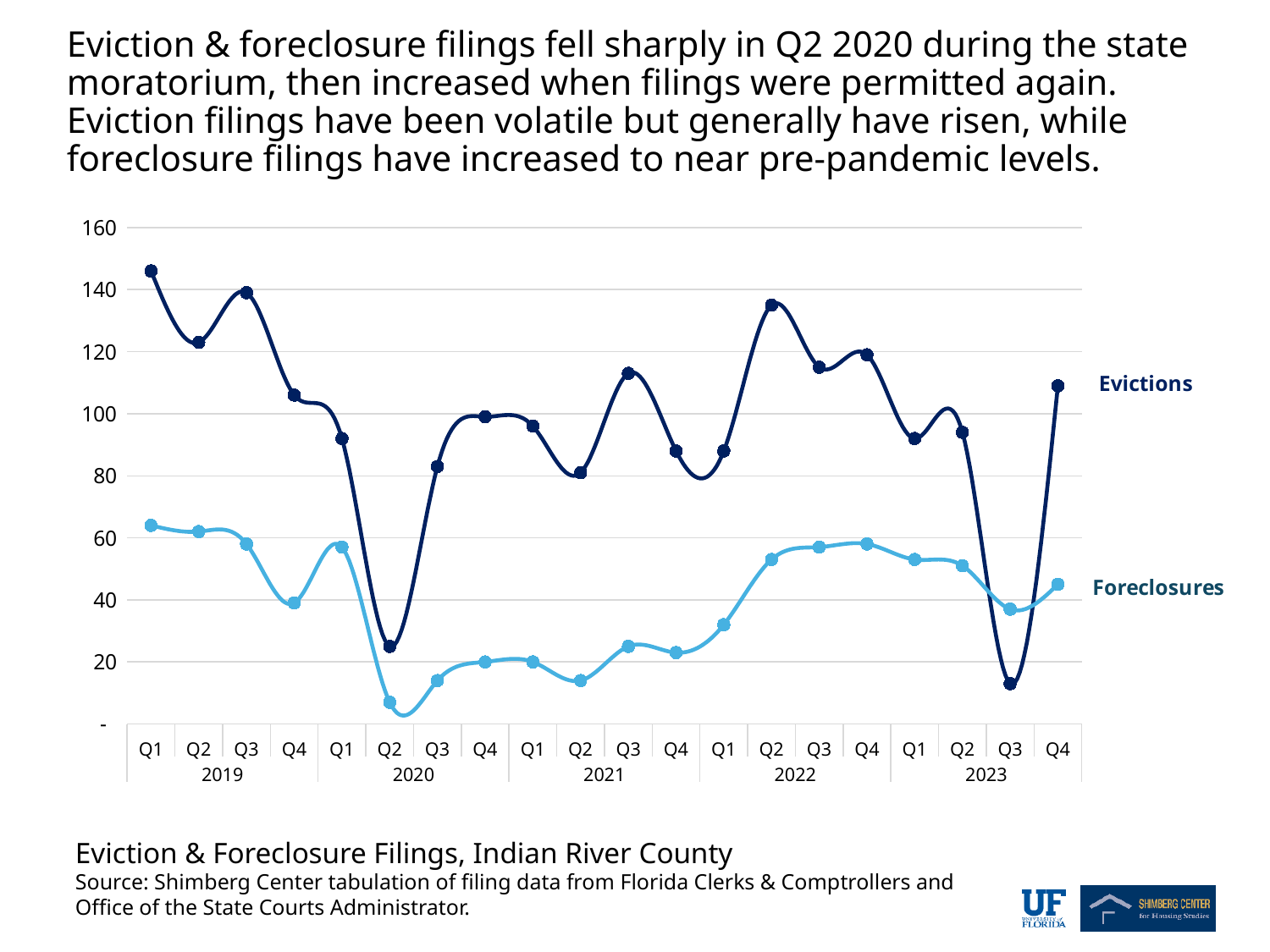
What kind of chart is shown on the slide? Line chart What is the title of the chart? Eviction & Foreclosure Filings, Indian River County Do Evictions rise or fall from Q1 2019 to Q1 2020? Fall Which is larger, the Evictions value in Q1 2019 or in Q2 2022? Q1 2019 In which quarter is the Evictions line at its lowest? Q3 2023 Is the Evictions value for Q2 2022 greater or less than 120? greater In which quarter is the Foreclosures line at its lowest? Q2 2020 How many series does the chart show? 2 In which quarter is the Evictions line at its highest? Q1 2019 Is the Evictions value for Q2 2020 greater or less than 40? less How many quarterly data points does each line have? 20 Is the Foreclosures value for Q4 2022 greater or less than 40? greater